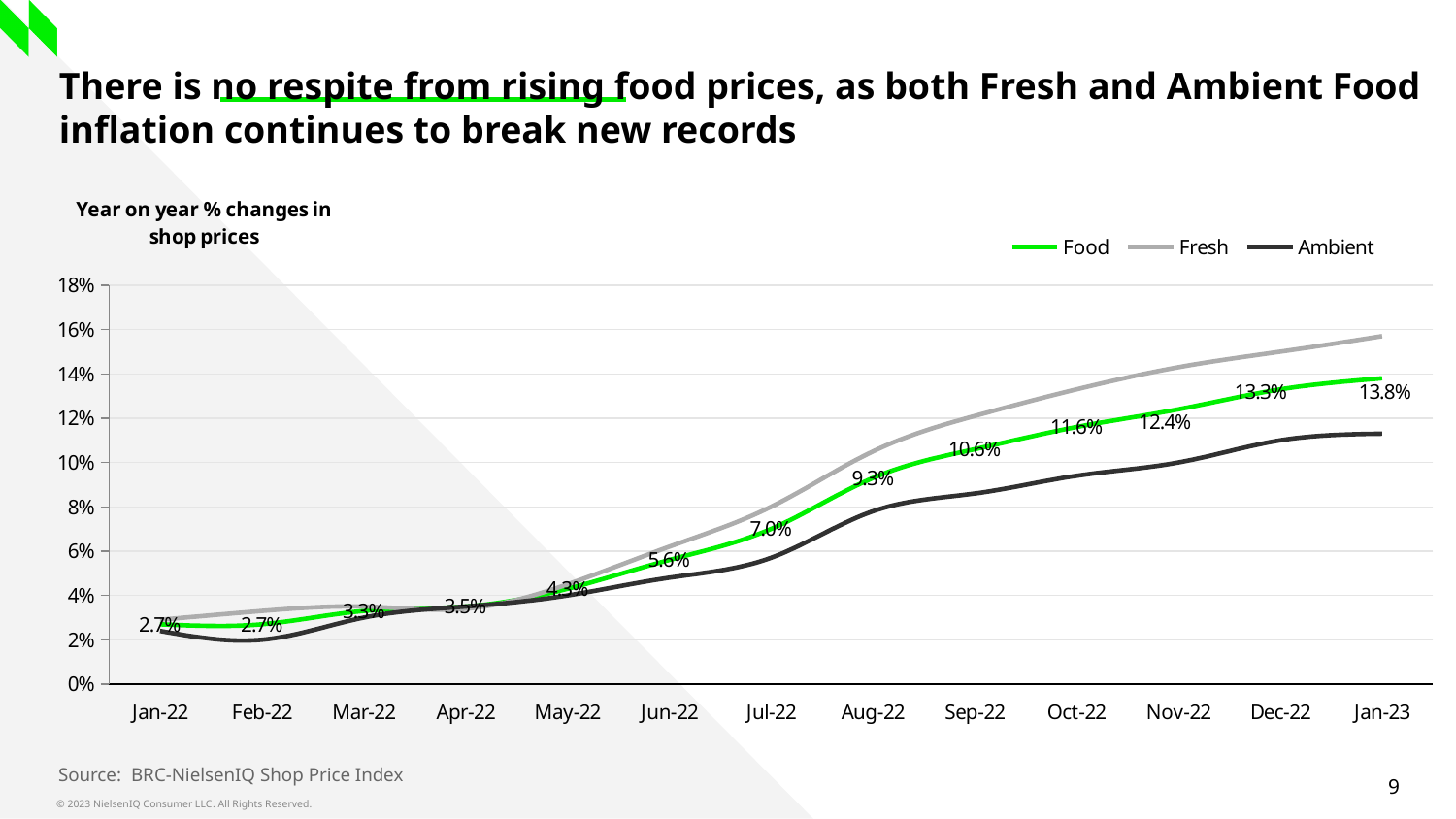
What is the difference between the Food values for Sep-22 and Jun-22? 5.0% What is the Food value for Jan-23? 13.8% Is the Fresh value for Jan-23 greater or less than 14%? greater How many series does the legend list? 3 What is the Food value for Jul-22? 7.0% What kind of chart is shown on the slide? Line chart Is the Ambient value for Jan-23 greater or less than 12%? less In which month is the Food value highest? Jan-23 What is the Food value for Nov-22? 12.4% What is the Food value for Aug-22? 9.3% What is the difference between the Food values for Jan-23 and Dec-22? 0.5% Which is larger, the Food value for Oct-22 or for Sep-22? Oct-22